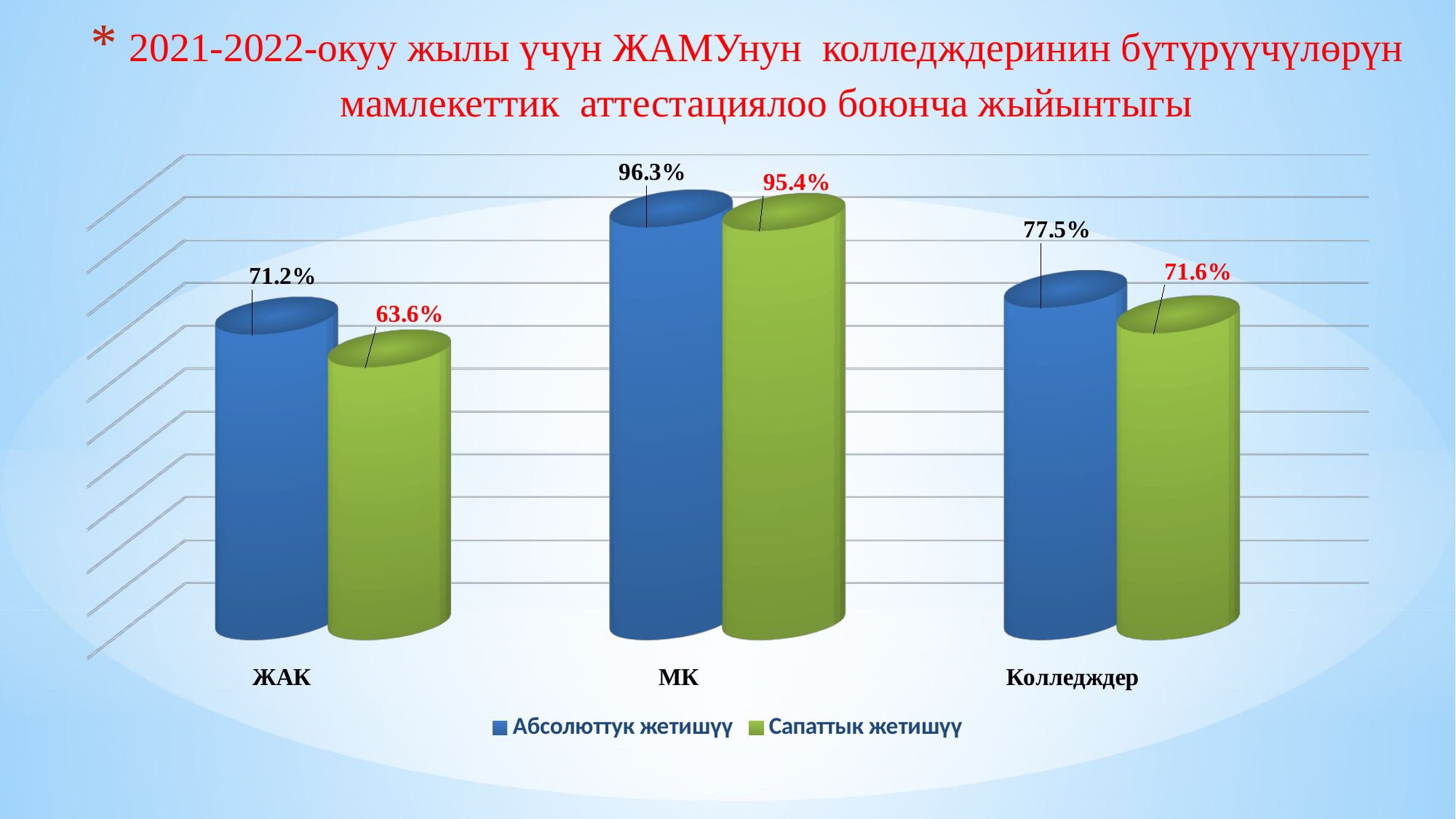
What is the value of Сапаттык жетишүү for МК? 95.4% How many series does the legend list? 2 Which is larger: Сапаттык жетишүү for Колледждер or Сапаттык жетишүү for ЖАК? Колледждер What is the value of Абсолюттук жетишүү for Колледждер? 77.5% What kind of chart is shown on the slide? Bar chart Which category has the highest Абсолюттук жетишүү value? МК What is the value of Сапаттык жетишүү for Колледждер? 71.6% What is the difference between Абсолюттук жетишүү and Сапаттык жетишүү for ЖАК? 7.6% Which category has the lowest Сапаттык жетишүү value? ЖАК What is the difference between the Абсолюттук жетишүү values for МК and Колледждер? 18.8% What is the value of Абсолюттук жетишүү for ЖАК? 71.2% How many categories are shown on the x axis? 3